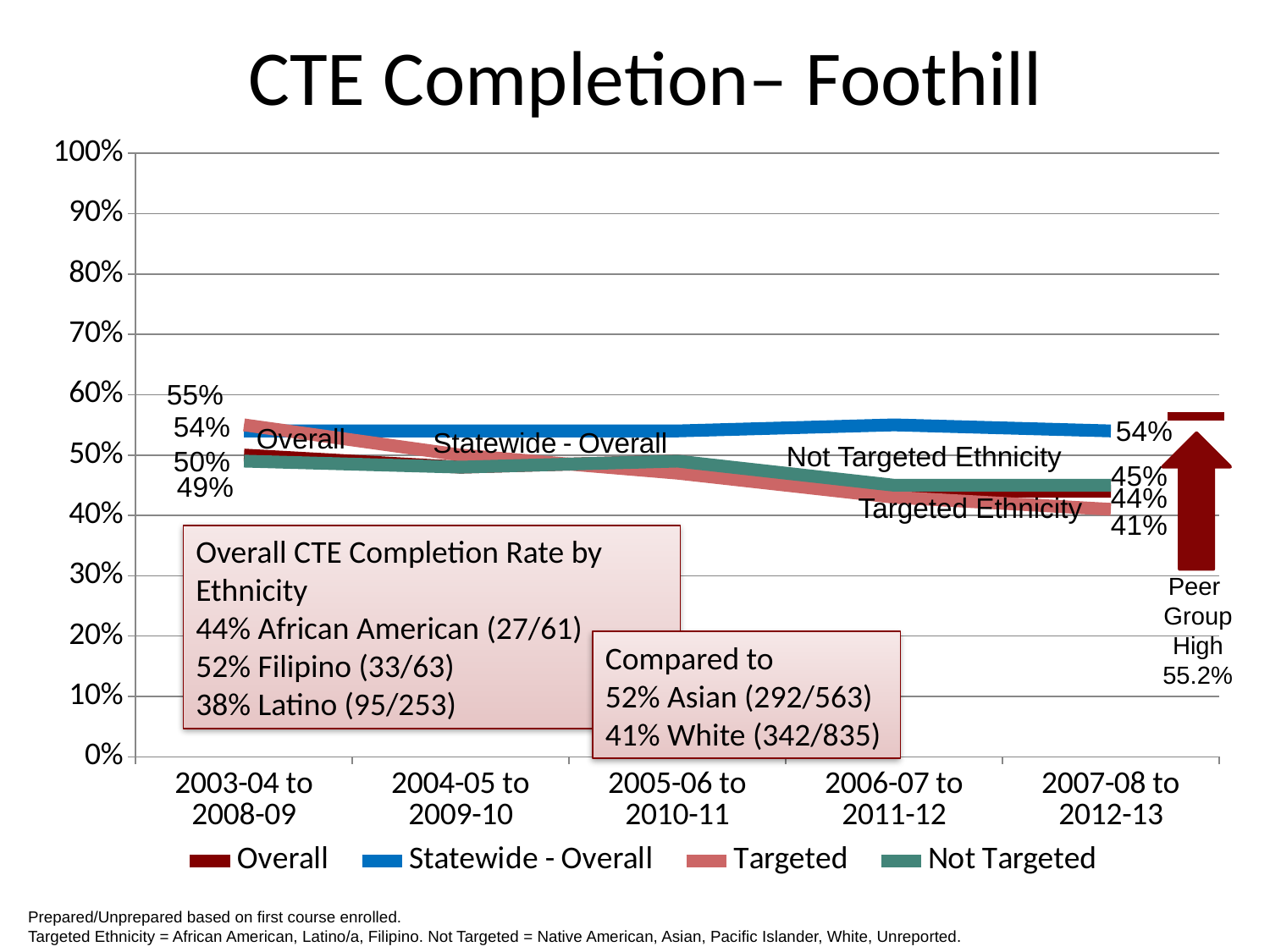
What type of chart is shown on the slide? Line chart How many cohort periods are shown on the x axis? 5 Does the Targeted series rise or fall from the first cohort to the last cohort? Fall Is the Targeted value for the 2007-08 to 2012-13 cohort greater or less than 50%? less For the 2007-08 to 2012-13 cohort, which is larger: the Not Targeted rate or the Targeted rate? Not Targeted Which series has the highest value for the 2007-08 to 2012-13 cohort? Statewide - Overall Which series has the lowest value for the 2007-08 to 2012-13 cohort? Targeted What is the Targeted CTE completion rate for the 2007-08 to 2012-13 cohort? 41% What is the difference between the Statewide - Overall rate and the Targeted rate for the 2007-08 to 2012-13 cohort? 13 percentage points What is the Statewide - Overall CTE completion rate for the 2007-08 to 2012-13 cohort? 54% How many series does the legend list? 4 What Peer Group High value is shown next to the chart? 55.2%